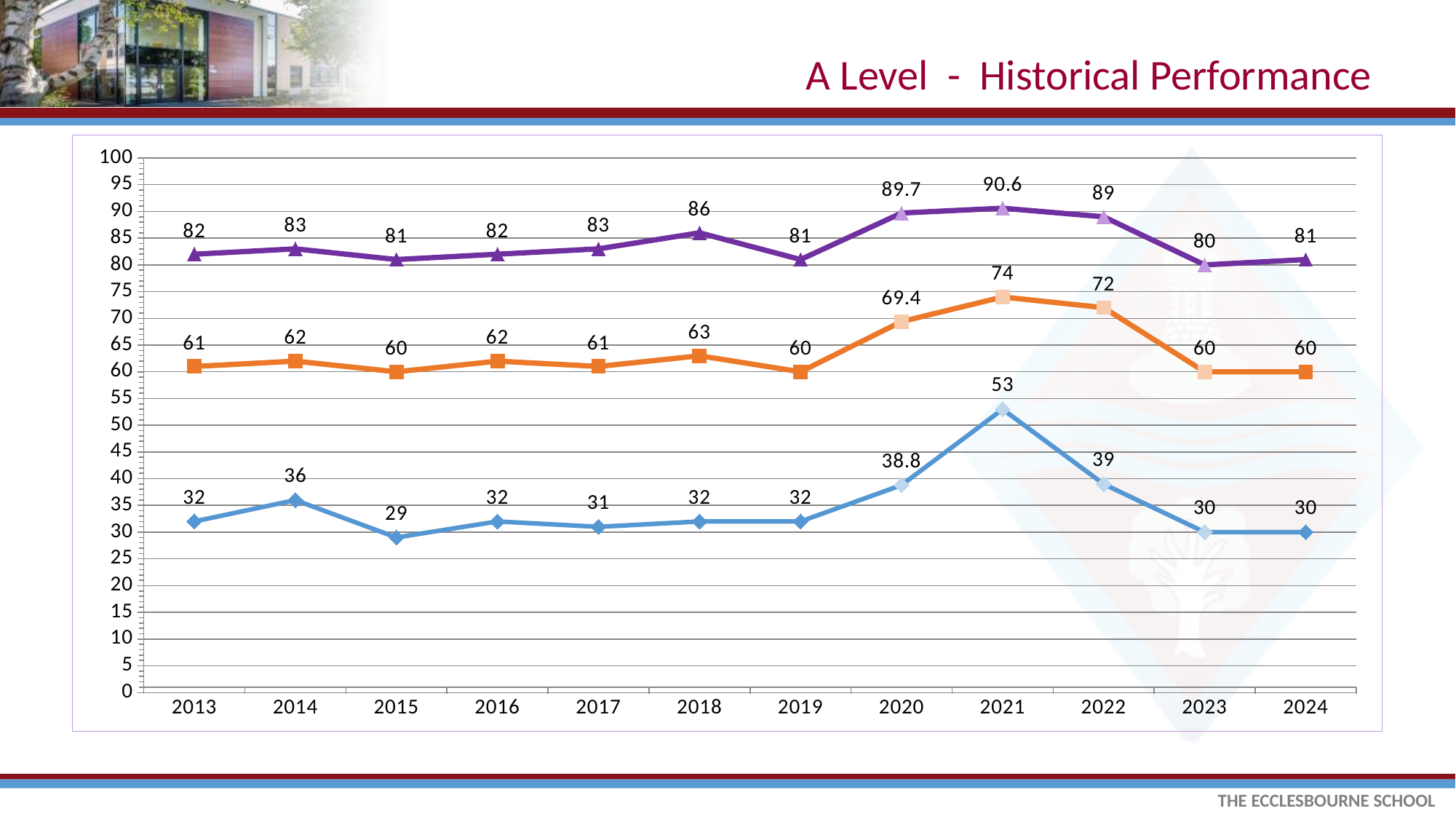
What is the difference between the middle (orange) line's value in 2021 and its value in 2024? 14 Does the top (purple) line rise or fall between 2022 and 2023? fall In which year does the top (purple) line have its lowest value? 2023 What is the value of the middle (orange) line in 2020? 69.4 What is the title of the slide containing the chart? A Level - Historical Performance What is the value of the bottom (blue) line in 2015? 29 In which year does the bottom (blue) line reach its highest value? 2021 What type of chart is shown on the slide? line chart What is the difference between the top (purple) line and the middle (orange) line in 2018? 23 How many years are plotted along the x axis? 12 Which is larger for the bottom (blue) line: the value in 2020 or the value in 2022? 2022 What is the value of the top (purple) line in 2021? 90.6